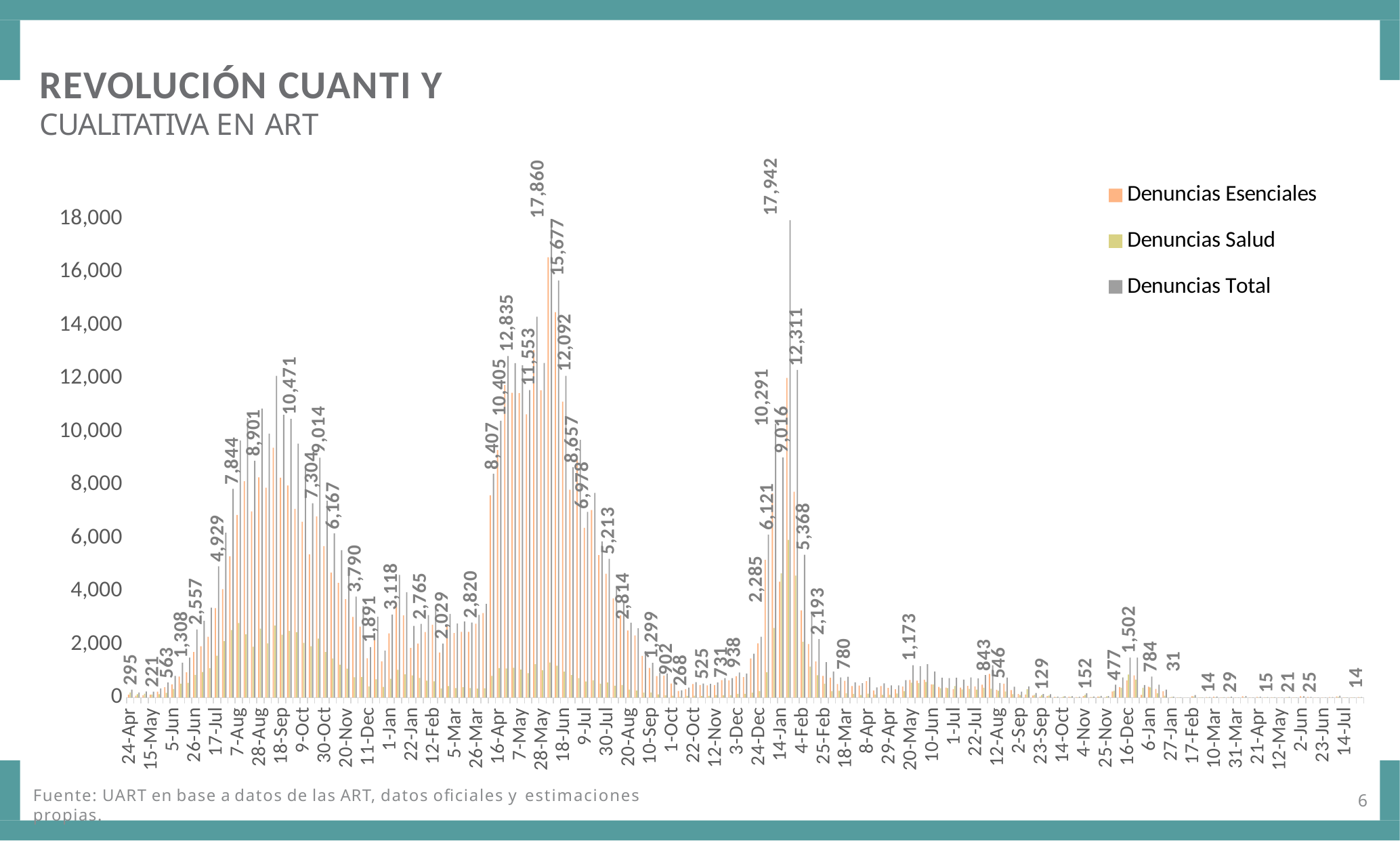
What is the data label on the peak near 28-May? 17,860 What kind of chart is shown on the slide? Bar chart What is the highest value shown on the vertical axis? 18,000 What are the three series named in the legend? Denuncias Esenciales, Denuncias Salud, Denuncias Total What is the smallest data label shown on the chart? 14 What is the highest data label shown on the chart? 17,942 From 14-Jan to 25-Feb, do the labeled values rise or fall? Fall Which labeled peak is larger, 17,942 (near 14-Jan) or 17,860 (near 28-May)? 17,942 What is the difference between the labeled values 15,677 and 12,092? 3,585 How many series does the legend list? 3 What is the difference between the two labeled peaks 17,942 and 17,860? 82 What is the data label on the peak near 14-Jan? 17,942